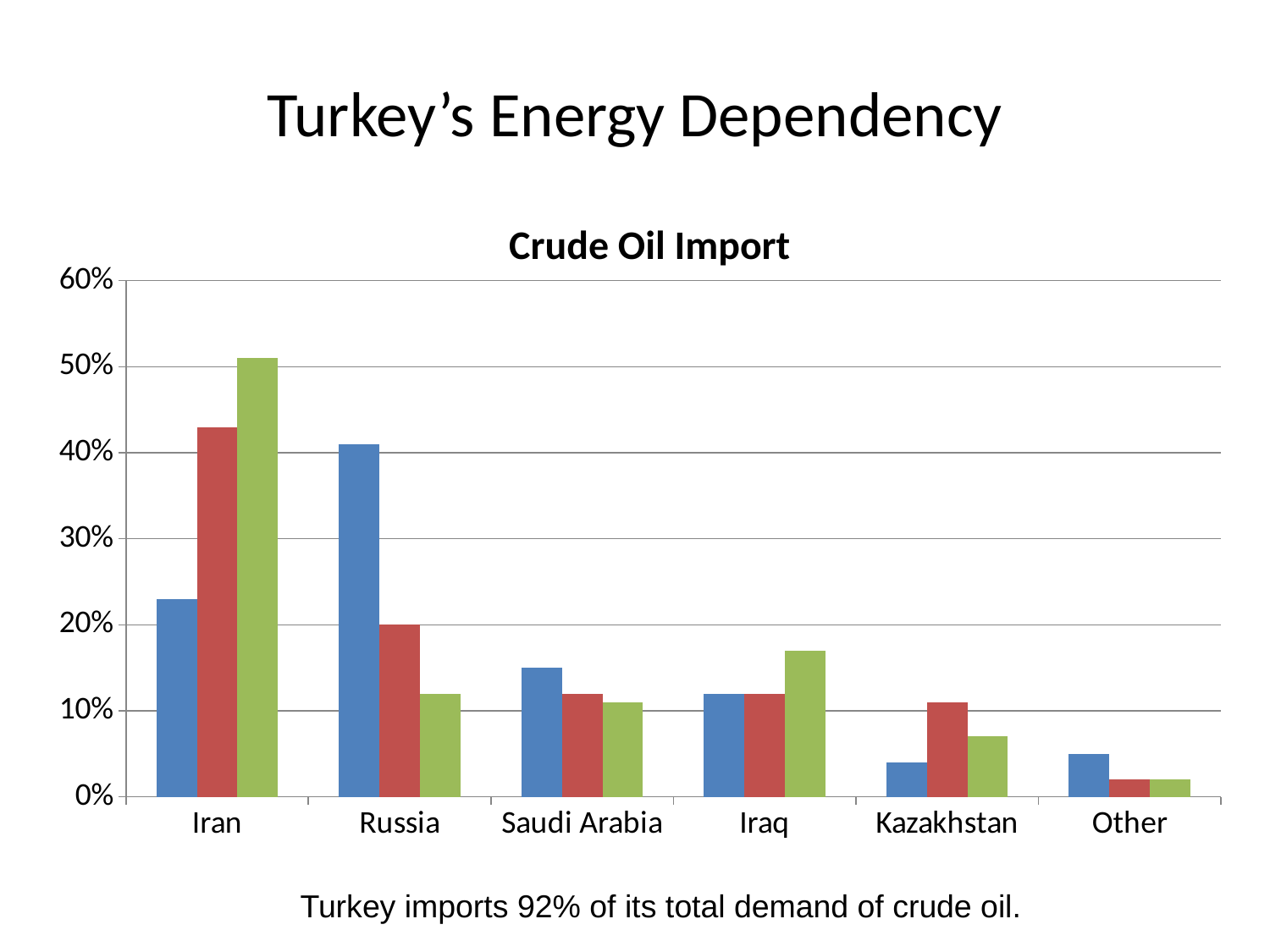
What is the title of the chart? Crude Oil Import Is the red bar for Iran greater or less than 40%? greater Is the blue bar for Iran greater or less than 20%? greater For which country is the blue bar the highest? Russia For which country is the green bar the highest? Iran For which country is the red bar the lowest? Other What kind of chart is shown on the slide? bar chart Is the green bar for Iraq greater or less than 20%? less For Russia, which is larger: the blue bar or the red bar? the blue bar How many bars are plotted for each country in the chart? 3 How many categories are shown on the x axis of the chart? 6